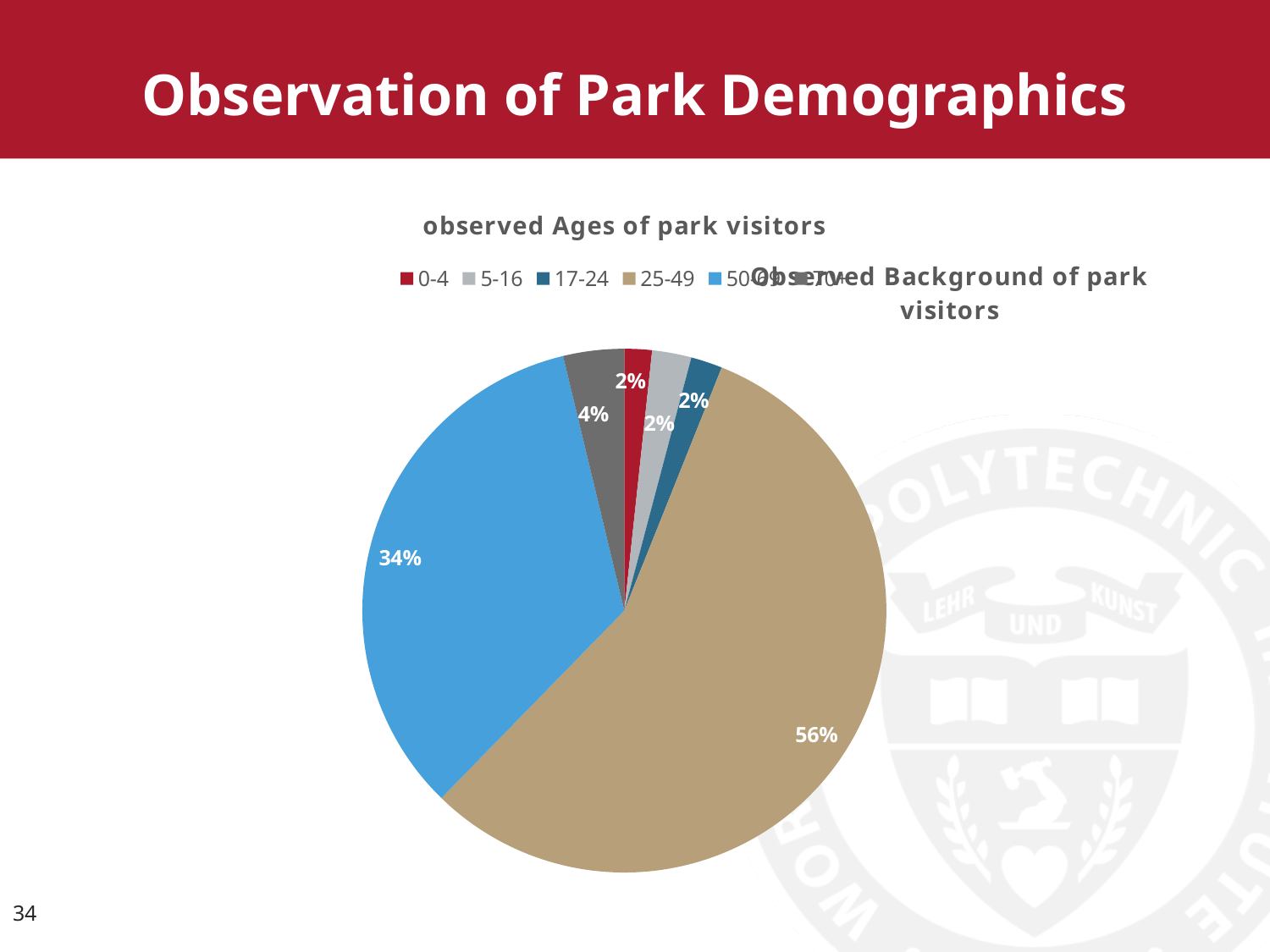
In the 'observed Ages of park visitors' chart, what percentage of visitors are aged 25-49? 56% Which age group has the largest slice in the 'observed Ages of park visitors' chart? 25-49 What is the title of the pie chart? observed Ages of park visitors What is the percentage shown on the second largest slice of the pie chart? 34% In the 'observed Ages of park visitors' chart, what percentage of visitors are aged 17-24? 2% What type of chart is shown on the slide? pie chart In the 'observed Ages of park visitors' chart, what percentage of visitors are aged 5-16? 2% What is the difference in percentage points between the 25-49 slice and the 17-24 slice? 54 How many slices does the 'observed Ages of park visitors' pie chart have? 6 In the 'observed Ages of park visitors' chart, what percentage of visitors are aged 0-4? 2% What is the smallest percentage value labelled on the pie chart? 2% Which slice is larger, 25-49 or 0-4? 25-49